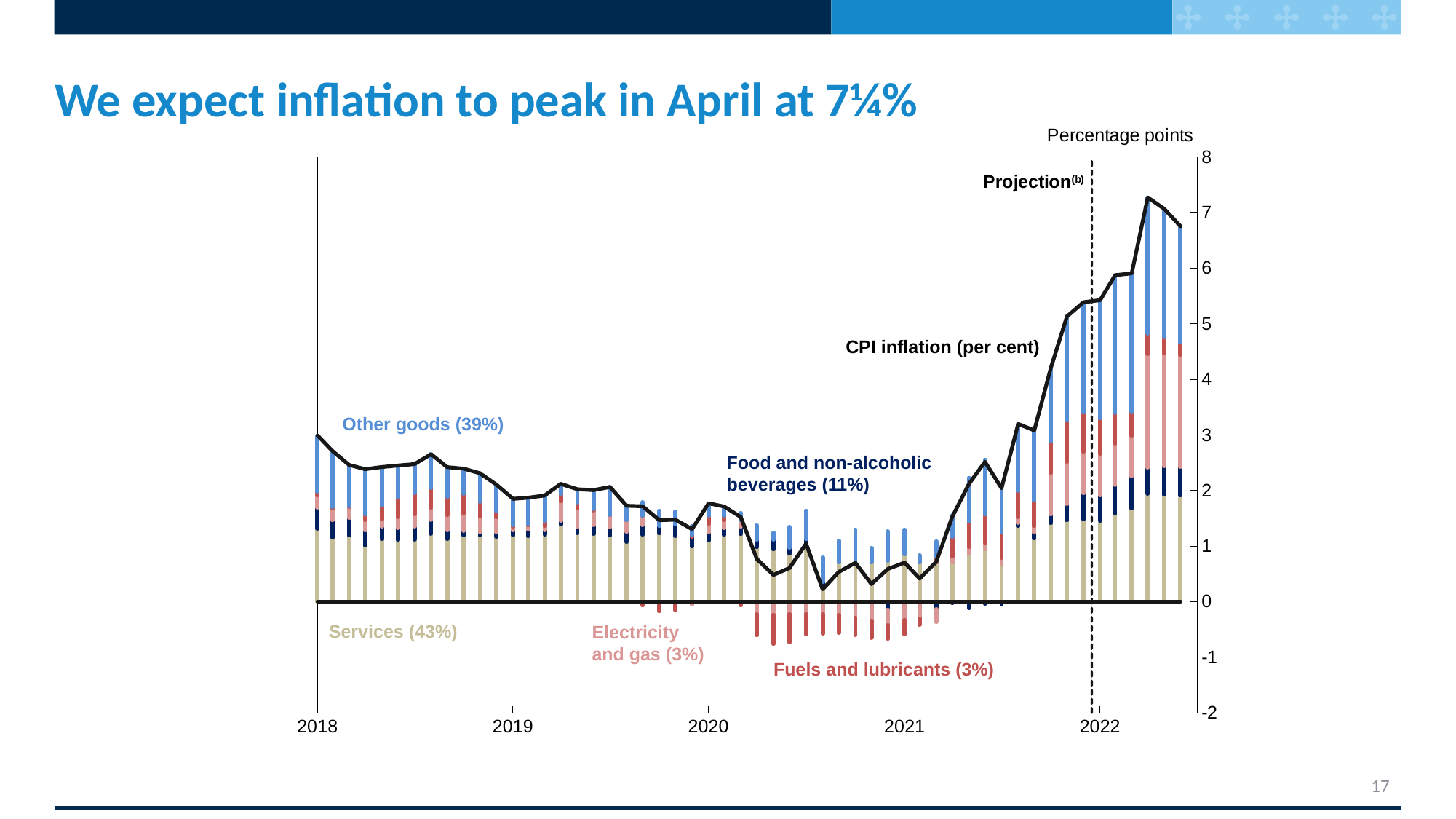
What kind of chart is shown on the slide? Stacked bar chart with a line Is the peak value of the CPI inflation line in 2022 greater or less than 7? greater Does the CPI inflation line rise or fall between 2018 and 2020? fall Is the CPI inflation line at the end of 2021 greater or less than 4? greater In which year shown on the x axis does the CPI inflation line reach its highest point? 2022 How many contribution components are labelled in the stacked bars? 5 Does the CPI inflation line rise or fall between 2021 and 2022? rise What is the title of the slide? We expect inflation to peak in April at 7¼% Which labelled component has the largest weight shown in brackets? Services (43%) What unit is shown above the y axis? Percentage points Is the contribution of Fuels and lubricants during 2020 greater or less than 0? less